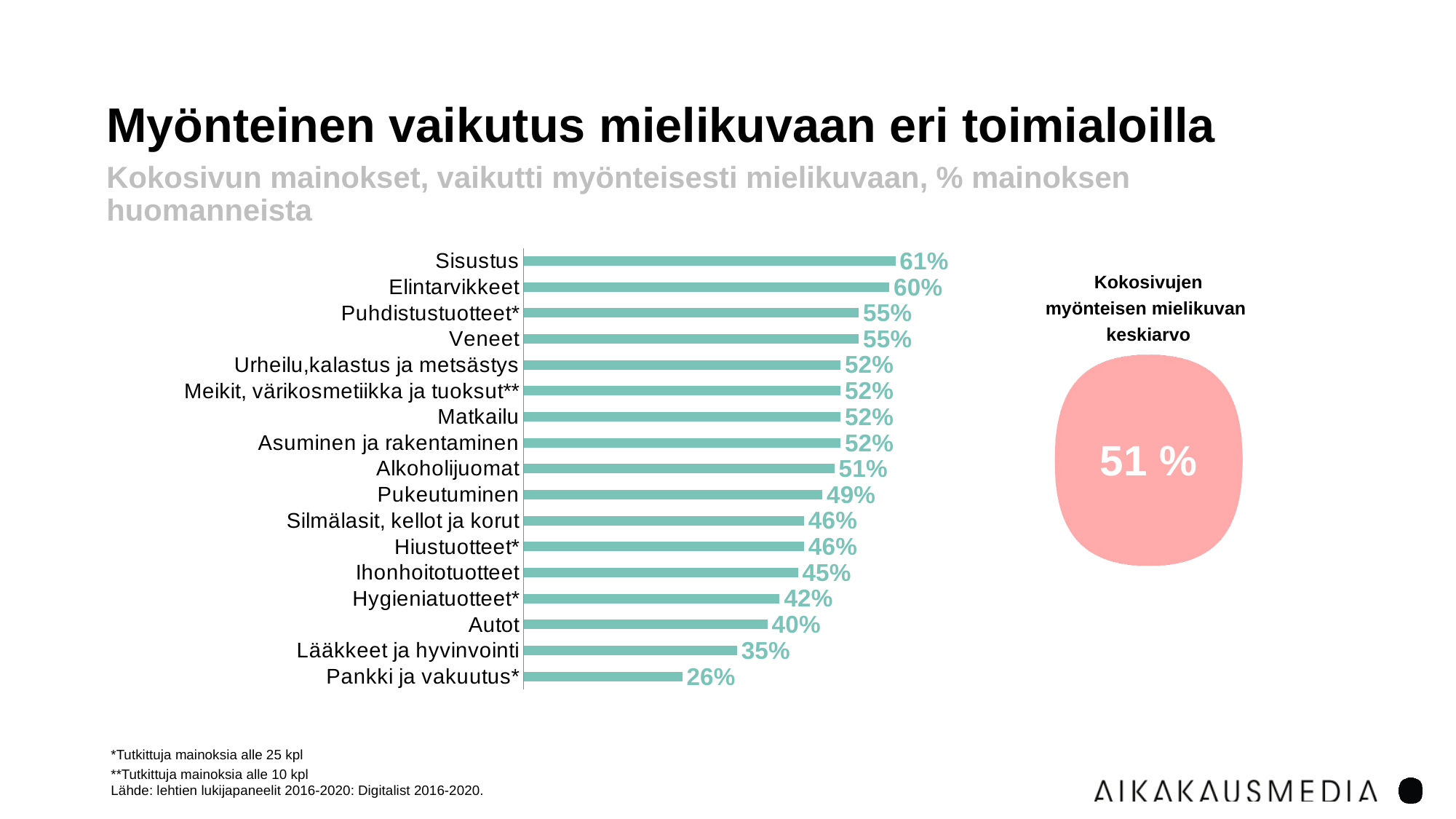
How many categories are shown in the bar chart? 17 What is the difference between the values for Elintarvikkeet and Autot? 20% Which category has the lowest value? Pankki ja vakuutus* Which category has the highest value? Sisustus What is the difference between the values for Sisustus and Pankki ja vakuutus*? 35% Which is larger, the value for Pukeutuminen or the value for Hygieniatuotteet*? Pukeutuminen What is the value for Sisustus? 61% What is the value for Autot? 40% What average value is shown in the pink circle labelled 'Kokosivujen myönteisen mielikuvan keskiarvo'? 51 % What is the value for Pankki ja vakuutus*? 26% What kind of chart is shown on the slide? Bar chart What is the value for Alkoholijuomat? 51%